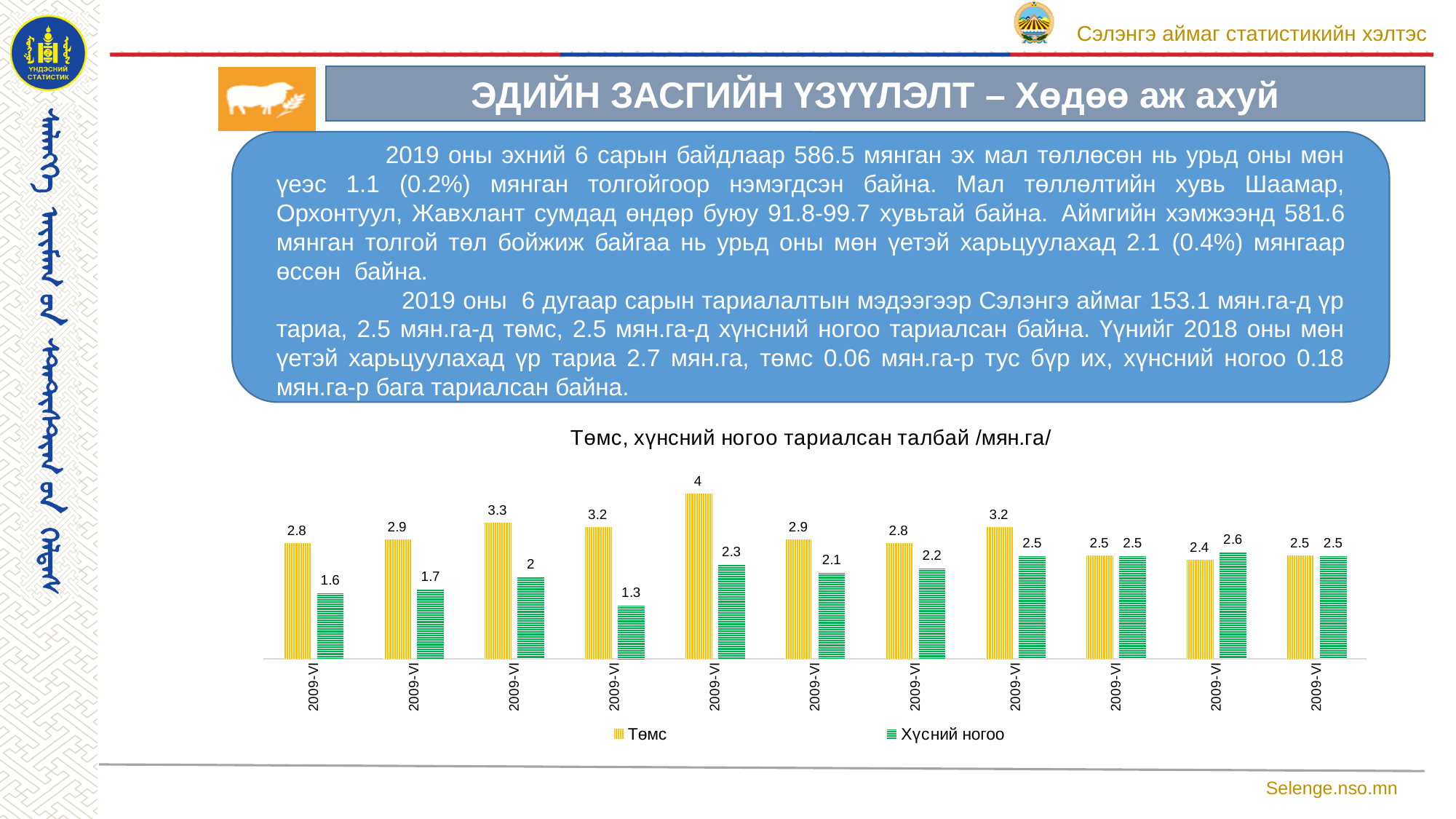
What is the Төмс value in the first (leftmost) group of bars? 2.8 What is the difference between the Төмс and Хүсний ногоо values in the first (leftmost) group of bars? 1.2 What is the Хүсний ногоо value in the first (leftmost) group of bars? 1.6 Which series is shown in green in the chart? Хүсний ногоо What is the highest value of the Төмс series? 4 What is the Хүсний ногоо value in the last (rightmost) group of bars? 2.5 How many groups of bars are plotted in the chart? 11 In the tenth group of bars (second from the right), which series has the larger value, Төмс or Хүсний ногоо? Хүсний ногоо What is the title of the chart? Төмс, хүнсний ногоо тариалсан талбай /мян.га/ What is the lowest value of the Хүсний ногоо series? 1.3 What kind of chart is shown on the slide? bar chart How many series does the chart legend list? 2